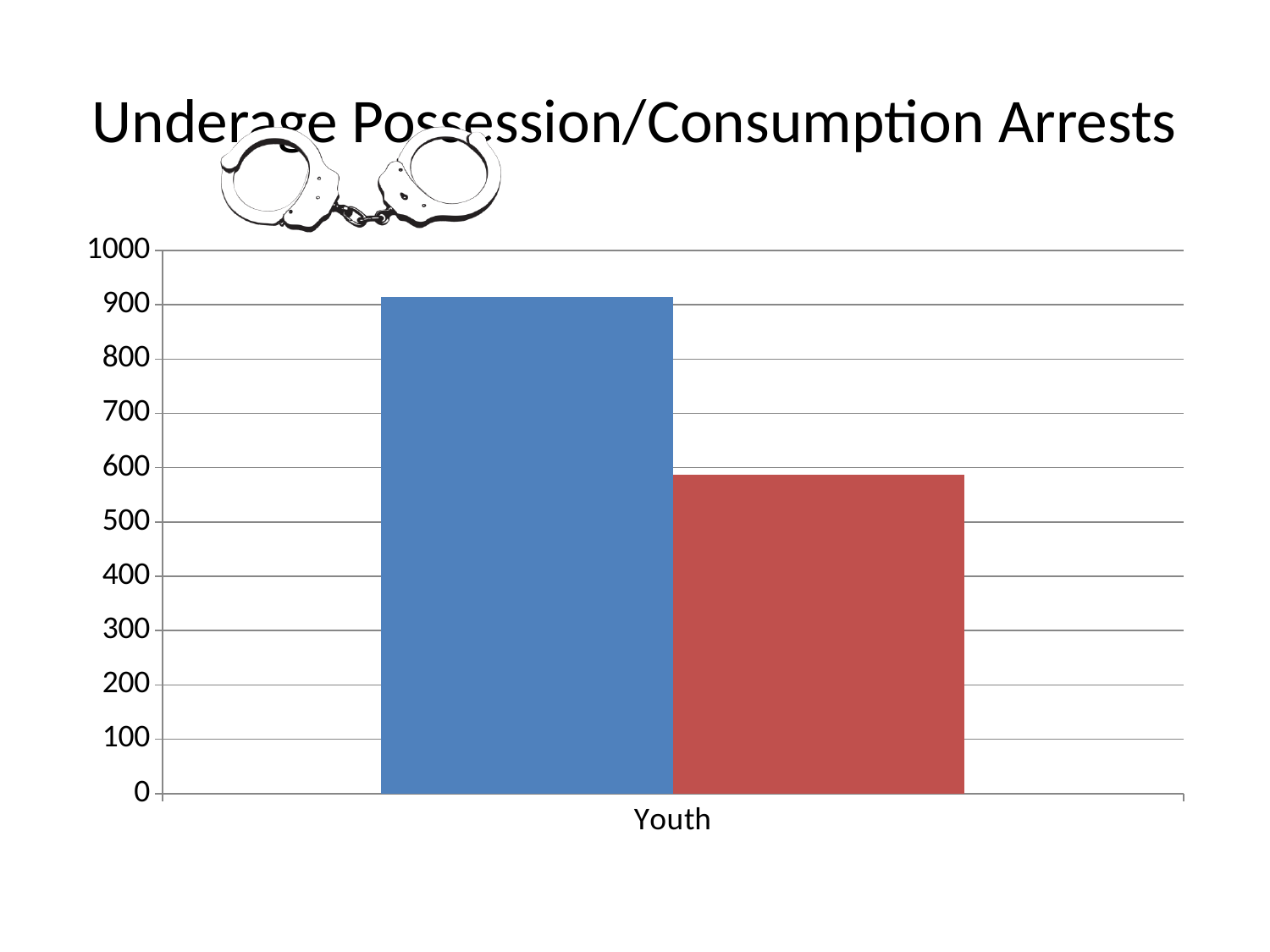
Which bar has the lowest value, the blue bar or the red bar? the red bar What is the highest value shown on the y axis? 1000 How many bars are plotted in the chart? 2 What is the title of the slide's chart? Underage Possession/Consumption Arrests What kind of chart is shown on the slide? bar chart Which bar is taller, the blue bar or the red bar? the blue bar Is the value of the red bar greater or less than 500? greater What is the only category label shown on the x axis? Youth How many categories are shown on the x axis? 1 Is the value of the blue bar greater or less than 1000? less